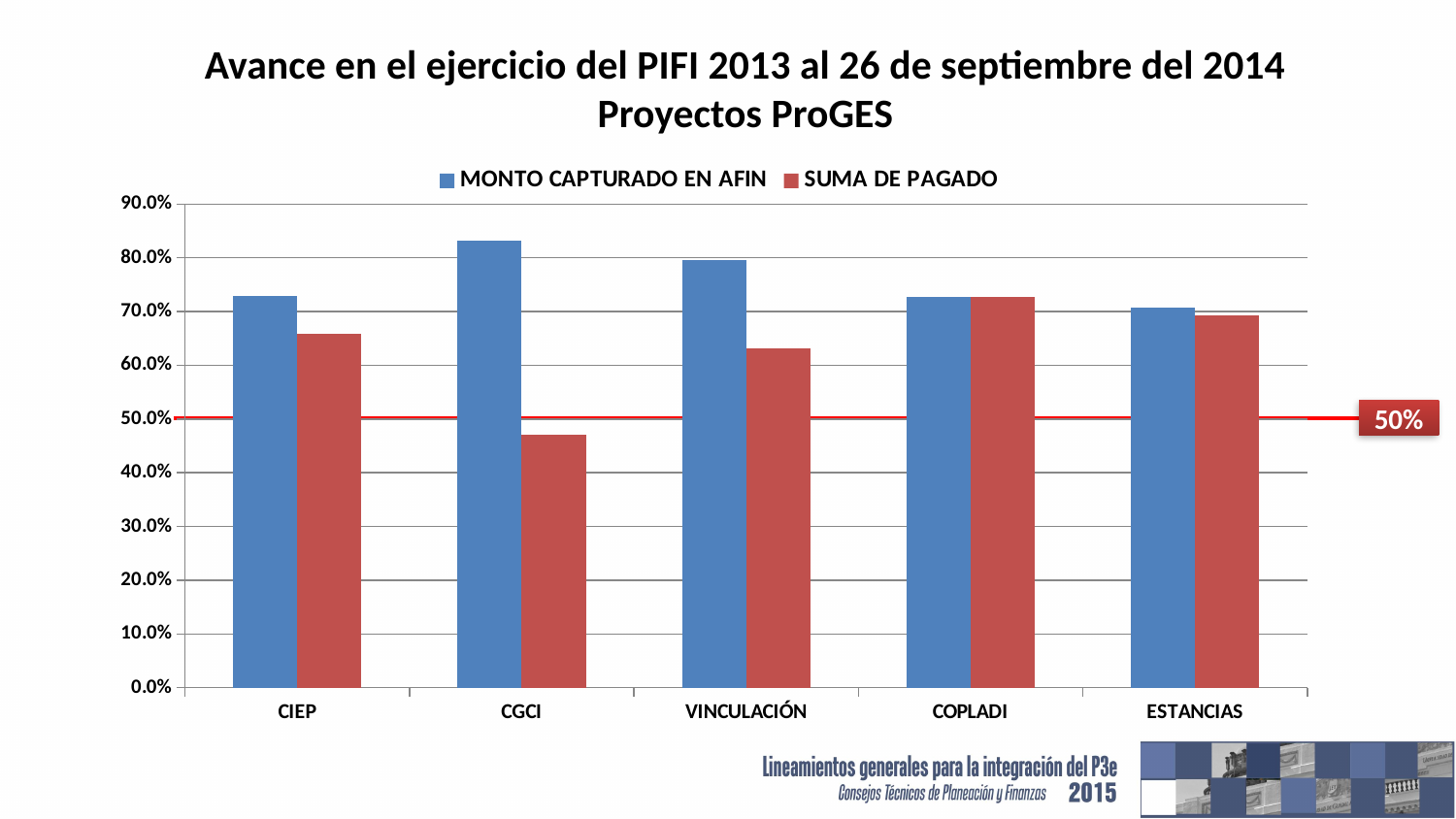
Which series is shown in blue in the chart's legend? MONTO CAPTURADO EN AFIN Is the MONTO CAPTURADO EN AFIN value for CGCI greater or less than 80%? greater What kind of chart is shown on the slide? Bar chart Which category has the lowest value for SUMA DE PAGADO? CGCI Is the SUMA DE PAGADO value for CGCI greater or less than 50%? less For VINCULACIÓN, which is larger: MONTO CAPTURADO EN AFIN or SUMA DE PAGADO? MONTO CAPTURADO EN AFIN How many categories are shown on the x axis of the chart? 5 What percentage does the red horizontal reference line on the chart mark? 50% Which category has the highest value for MONTO CAPTURADO EN AFIN? CGCI How many series does the chart's legend list? 2 Is the MONTO CAPTURADO EN AFIN value for CIEP greater or less than 70%? greater